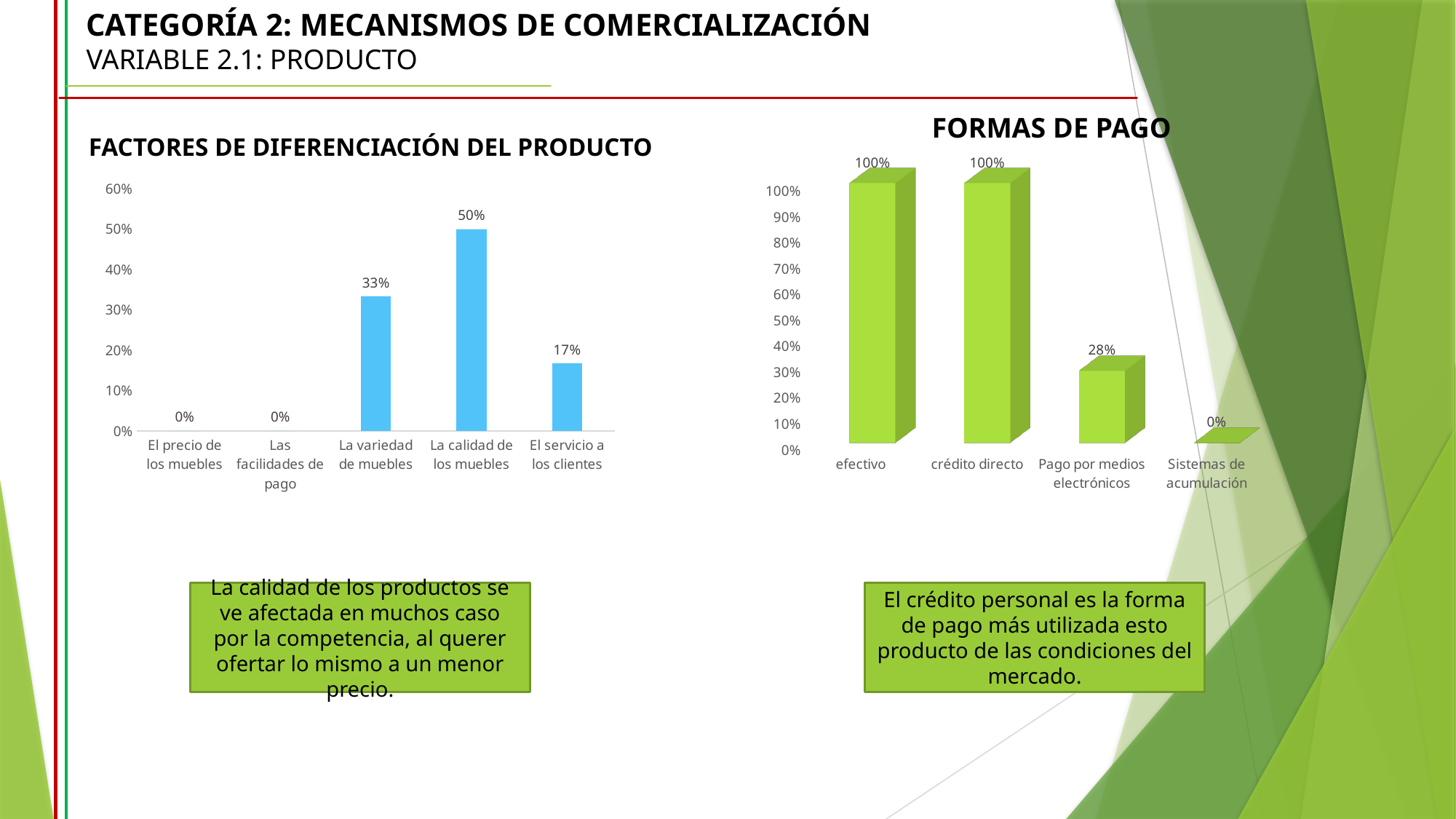
In the 'FORMAS DE PAGO' chart, what is the difference between 'efectivo' and 'Pago por medios electrónicos'? 72% In the 'FORMAS DE PAGO' chart, what is the value for 'Pago por medios electrónicos'? 28% In the 'FORMAS DE PAGO' chart, which category has the lowest value? Sistemas de acumulación In the 'FACTORES DE DIFERENCIACIÓN DEL PRODUCTO' chart, what is the value for 'La calidad de los muebles'? 50% What type of chart is the 'FORMAS DE PAGO' chart? Bar chart In the 'FACTORES DE DIFERENCIACIÓN DEL PRODUCTO' chart, how many categories are shown on the x axis? 5 In the 'FORMAS DE PAGO' chart, which is larger: 'crédito directo' or 'Pago por medios electrónicos'? crédito directo In the 'FACTORES DE DIFERENCIACIÓN DEL PRODUCTO' chart, what is the value for 'La variedad de muebles'? 33% In the 'FACTORES DE DIFERENCIACIÓN DEL PRODUCTO' chart, which category has the highest value? La calidad de los muebles In the 'FACTORES DE DIFERENCIACIÓN DEL PRODUCTO' chart, how many categories have a value of 0%? 2 In the 'FACTORES DE DIFERENCIACIÓN DEL PRODUCTO' chart, what is the difference between 'La calidad de los muebles' and 'El servicio a los clientes'? 33% In the 'FORMAS DE PAGO' chart, what is the value for 'efectivo'? 100%